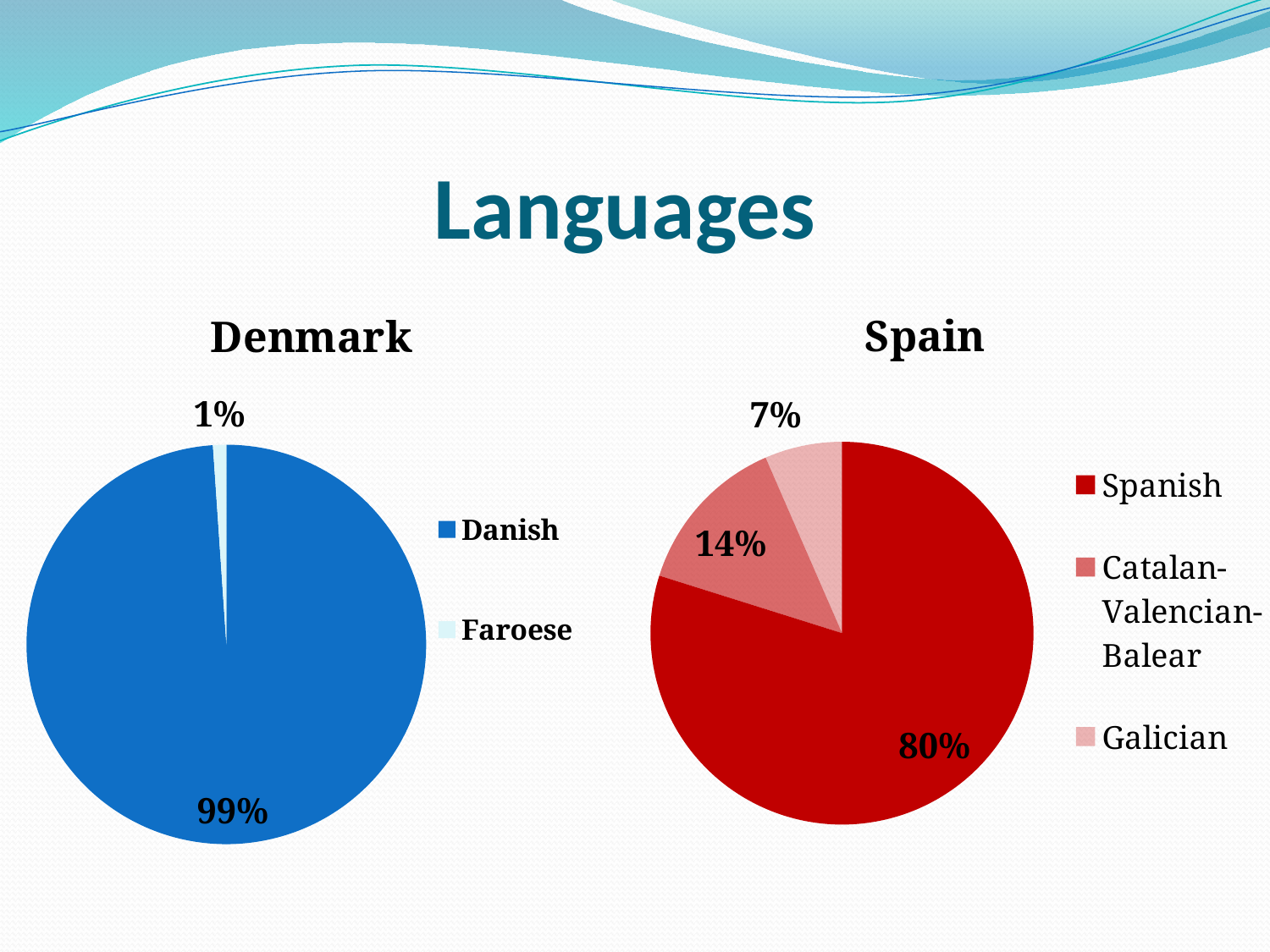
How many slices does the Spain chart have? 3 What type of chart is the Denmark chart? Pie chart In the Spain chart, what percentage is shown for Galician? 7% In the Spain chart, which language has the smallest slice? Galician In the Spain chart, which language has the largest slice? Spanish In the Spain chart, what percentage is shown for Catalan-Valencian-Balear? 14% In the Spain chart, which is larger, Catalan-Valencian-Balear or Galician? Catalan-Valencian-Balear In the Spain chart, what percentage is shown for Spanish? 80% In the Denmark chart, what is the difference in percentage points between Danish and Faroese? 98 In the Denmark chart, what percentage is shown for Danish? 99% In the Denmark chart, what percentage is shown for Faroese? 1% In the Spain chart, what is the difference in percentage points between Spanish and Catalan-Valencian-Balear? 66